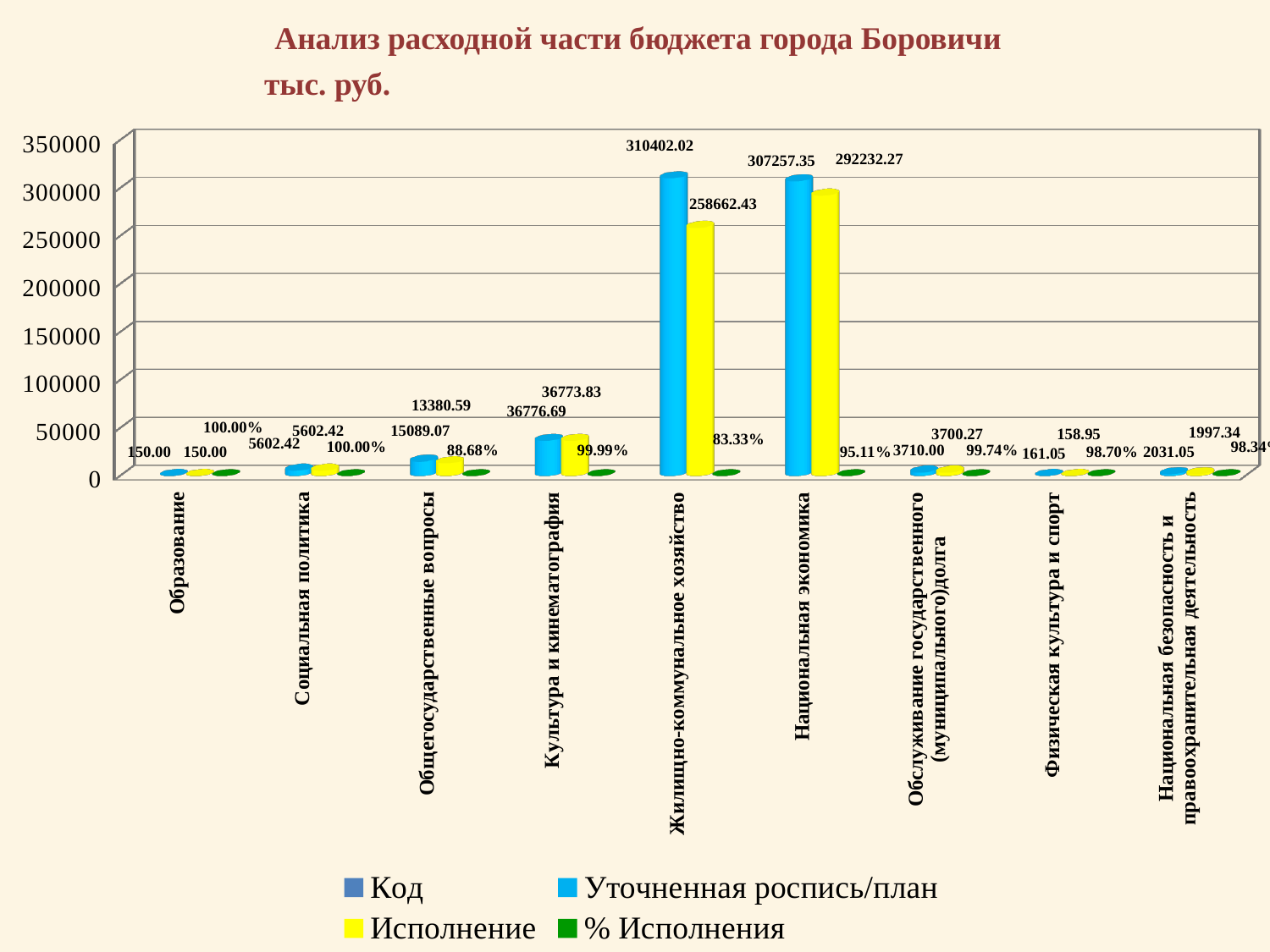
What is the 'Исполнение' value for Физическая культура и спорт? 158.95 Is the 'Уточненная роспись/план' value for Национальная экономика greater or less than 300000? greater Which is larger: the 'Исполнение' value for Национальная экономика or for Жилищно-коммунальное хозяйство? Национальная экономика How many categories are shown on the x axis? 9 What is the '% Исполнения' value for Общегосударственные вопросы? 88.68% Which category has the lowest '% Исполнения' value? Жилищно-коммунальное хозяйство What is the 'Исполнение' value for Национальная экономика? 292232.27 Which category has the highest 'Уточненная роспись/план' value? Жилищно-коммунальное хозяйство How many series does the legend list? 4 What is the difference between the 'Уточненная роспись/план' and 'Исполнение' values for Жилищно-коммунальное хозяйство? 51739.59 What is the 'Уточненная роспись/план' value for Жилищно-коммунальное хозяйство? 310402.02 What kind of chart is shown on the slide? bar chart